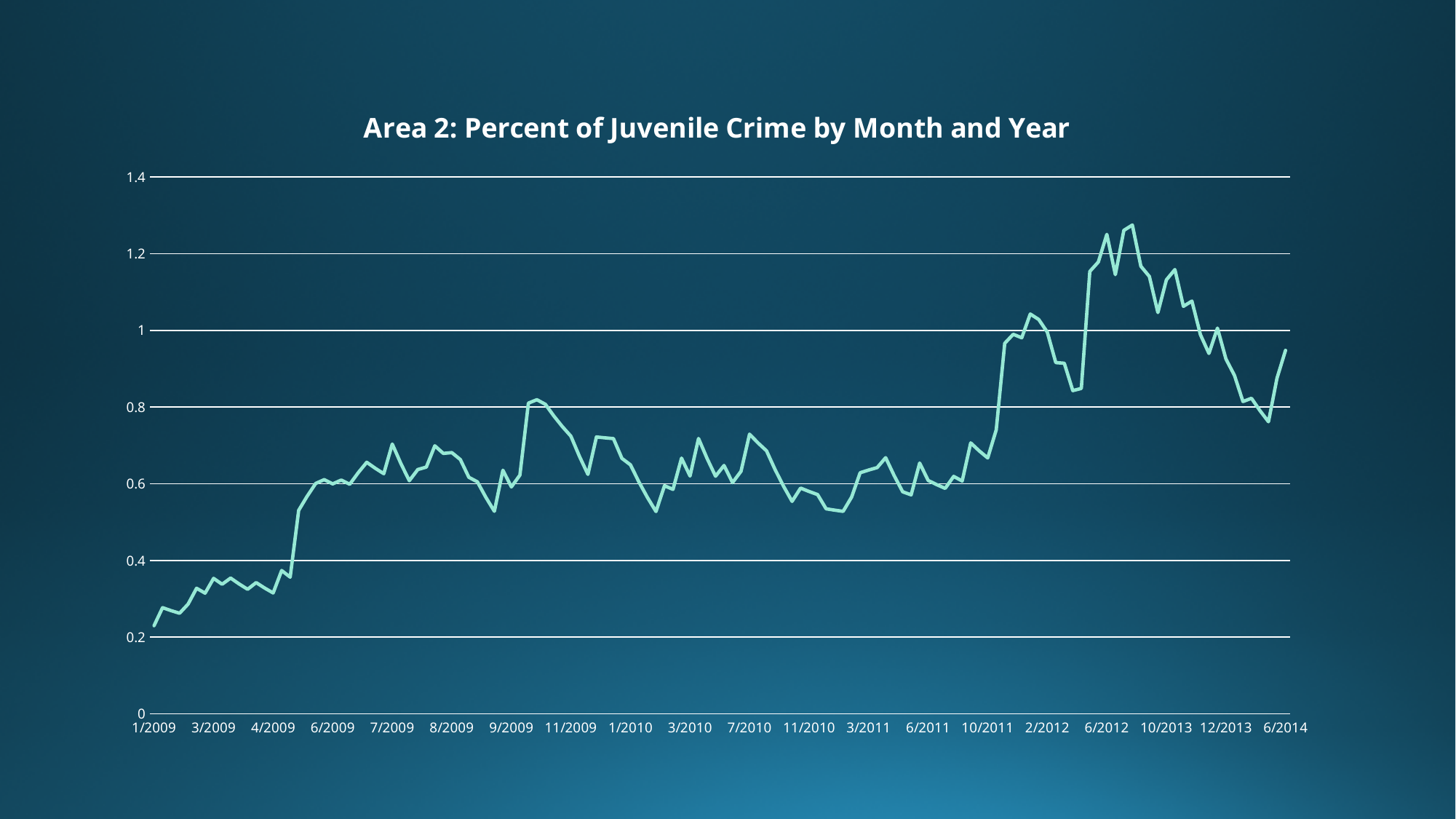
Is the highest point on the line greater or less than 1.2? greater How many date labels are shown on the x axis? 20 Is the value for 1/2009 greater or less than 0.4? less Is the value for 11/2009 greater or less than 1? less Overall, does the line rise or fall from 1/2009 to 6/2014? rise Which of the two values is larger, 1/2009 or 6/2014? 6/2014 What is the title of the chart? Area 2: Percent of Juvenile Crime by Month and Year What kind of chart is shown on the slide? line chart